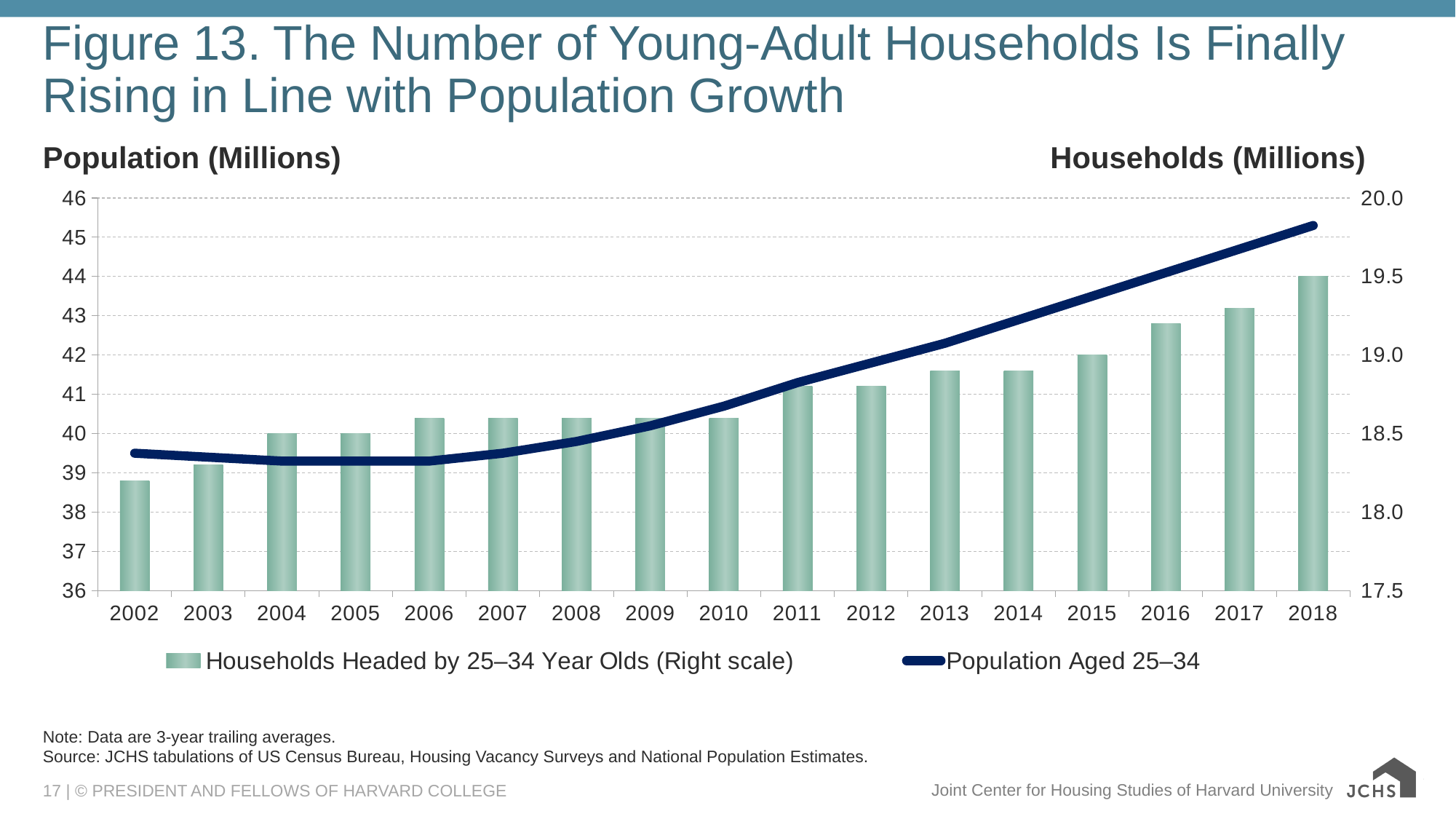
How many series does the legend list? 2 Does the Population Aged 25–34 line rise or fall from 2011 to 2018? Rises Is the value for Population Aged 25–34 in 2002 greater or less than 40 million? less What kind of chart is shown on the slide? A combined bar and line chart How many years are shown on the x axis? 17 Which year has the larger bar for Households Headed by 25–34 Year Olds, 2012 or 2016? 2016 Is the value for Population Aged 25–34 in 2018 greater or less than 44 million? greater In which year is the bar for Households Headed by 25–34 Year Olds the highest? 2018 Which axis scale is used for the Households Headed by 25–34 Year Olds series? The right scale (Households, Millions) Is the value for Households Headed by 25–34 Year Olds in 2002 greater or less than 18.5 million? less In which year is the bar for Households Headed by 25–34 Year Olds the lowest? 2002